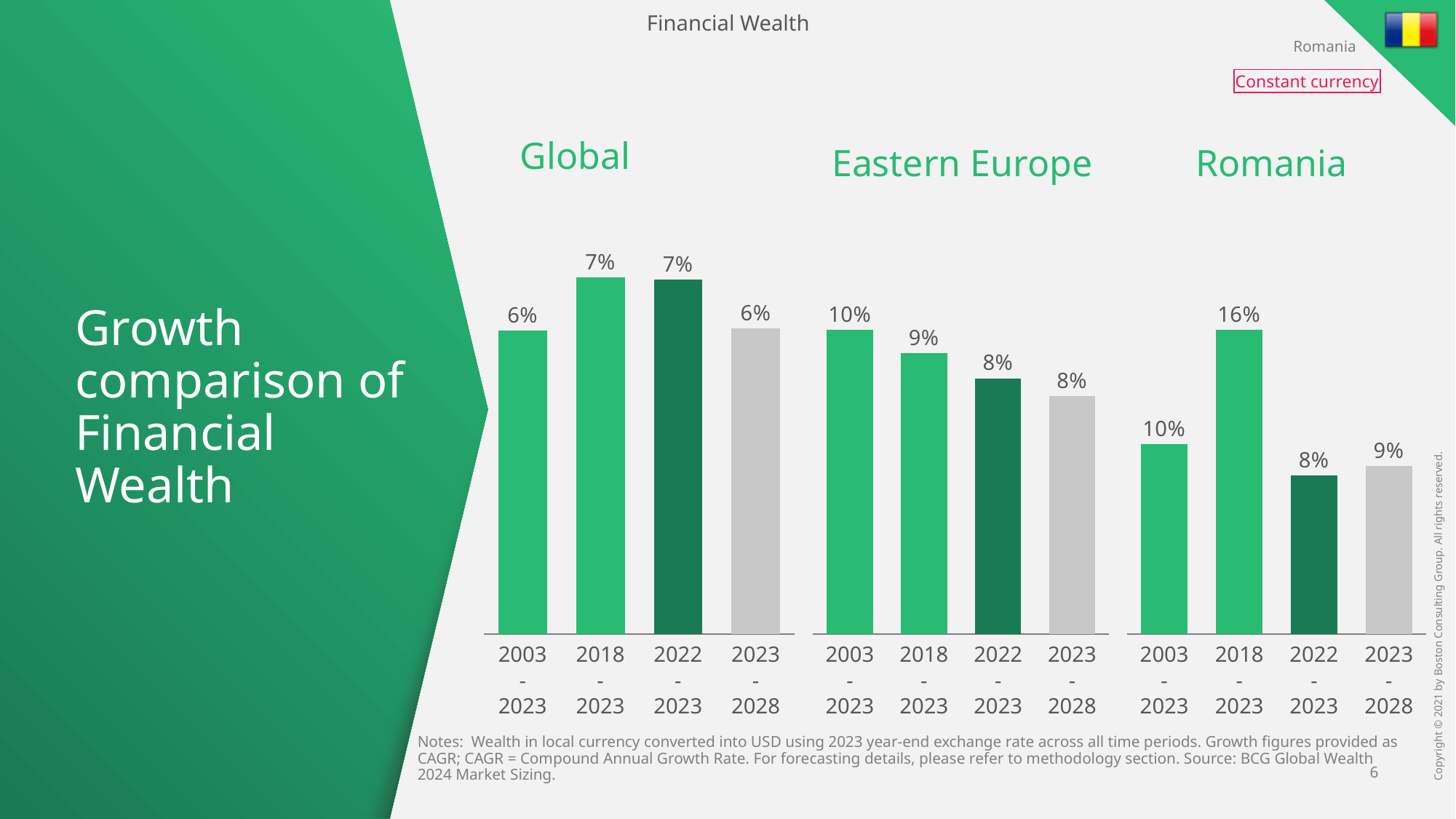
In the Eastern Europe chart, do the values rise or fall from 2003-2023 to 2022-2023? Fall In the Romania chart, what is the difference between the 2018-2023 value and the 2022-2023 value? 8% In the Romania chart, which period has the lowest growth value? 2022-2023 In the Eastern Europe chart, what is the difference between the 2003-2023 value and the 2023-2028 value? 2% In the Eastern Europe chart, which period has the highest growth value? 2003-2023 In the Romania chart, what is the growth value for 2023-2028? 9% In the Eastern Europe chart, what is the growth value for 2018-2023? 9% In the Romania chart, which period has the highest growth value? 2018-2023 In the Romania chart, which is larger: the value for 2003-2023 or the value for 2023-2028? 2003-2023 What kind of chart is used for the Eastern Europe data? Bar chart How many bars are shown in the Global chart? 4 In the Global chart, what is the growth value for 2003-2023? 6%